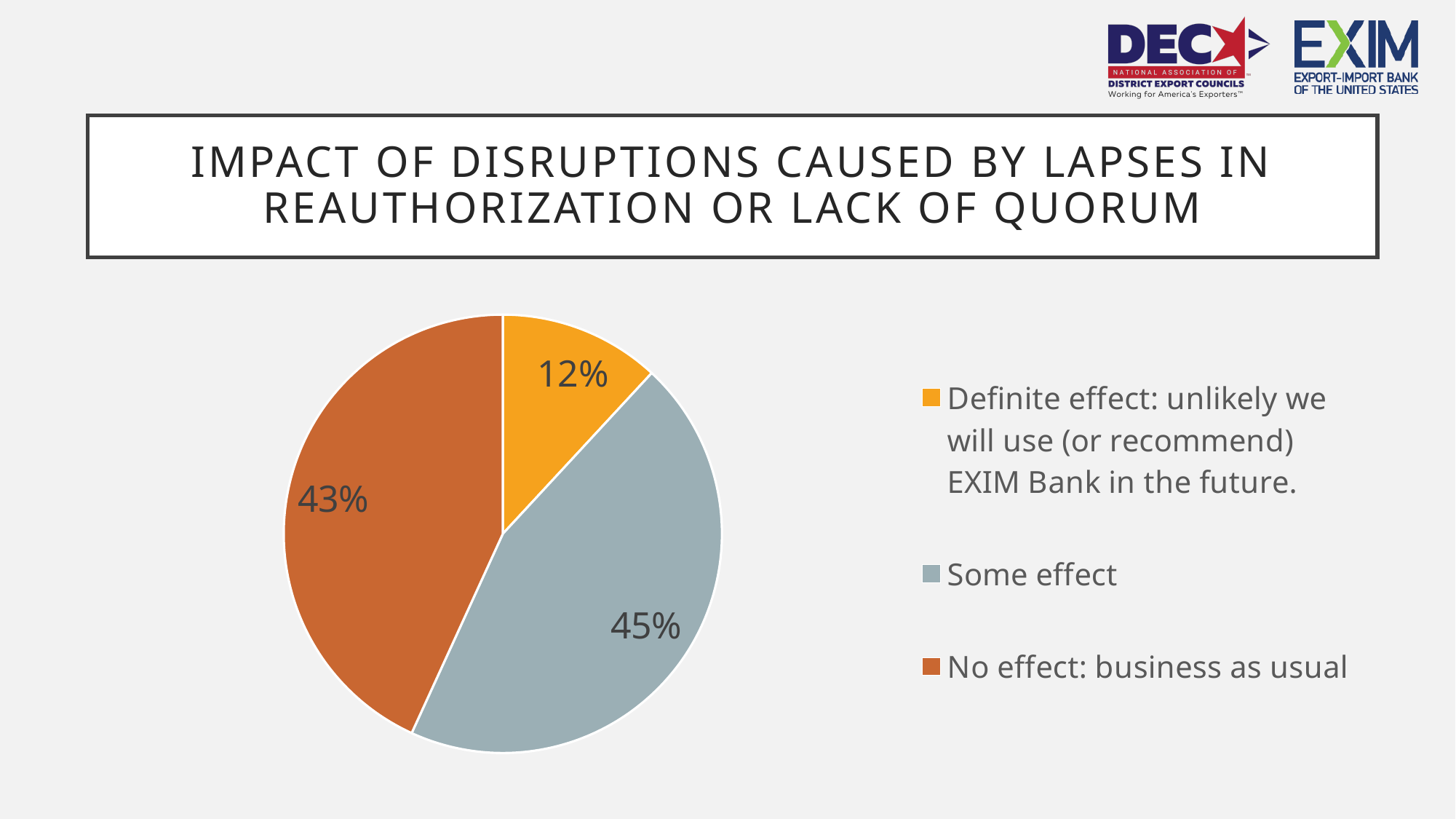
What colour is the "No effect: business as usual" slice? Orange-brown What kind of chart is shown on the slide? Pie chart Which is larger: the "Some effect" slice or the "Definite effect" slice? Some effect What share of the pie is labelled "Definite effect: unlikely we will use (or recommend) EXIM Bank in the future."? 12% How many slices does the pie chart have? 3 Which category has the smallest slice of the pie? Definite effect: unlikely we will use (or recommend) EXIM Bank in the future. What share of the pie is labelled "Some effect"? 45% What is the title of the slide containing the pie chart? Impact of Disruptions Caused by Lapses in Reauthorization or Lack of Quorum What share of the pie is labelled "No effect: business as usual"? 43% Which category has the largest slice of the pie? Some effect What is the difference in percentage points between the "No effect: business as usual" slice and the "Definite effect" slice? 31 percentage points What is the difference in percentage points between the "Some effect" slice and the "No effect: business as usual" slice? 2 percentage points